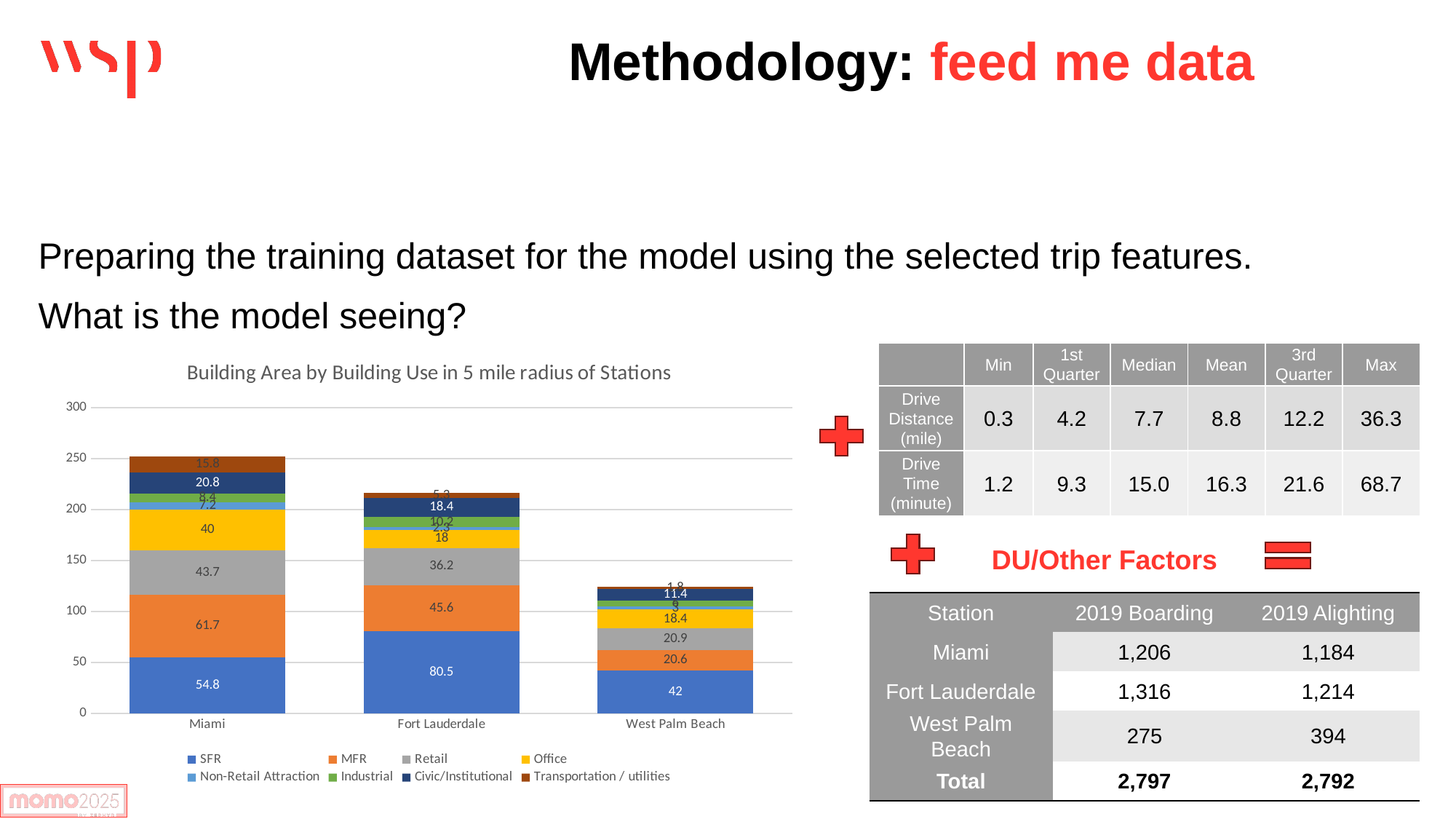
How many stations (categories) are shown on the x axis of the chart? 3 What is the title of the chart? Building Area by Building Use in 5 mile radius of Stations How many series does the chart's legend list? 8 What kind of chart is shown on the slide? Stacked bar chart Which station has the lowest total building area (shortest stacked bar)? West Palm Beach What is the difference between the SFR value for Fort Lauderdale and the SFR value for Miami? 25.7 What is the Retail value for West Palm Beach? 20.9 What is the MFR value for Miami? 61.7 What is the SFR value for Fort Lauderdale? 80.5 Which station has the highest SFR value? Fort Lauderdale Is the total stacked bar for West Palm Beach greater or less than 150? less Which is larger, the MFR value for Miami or the MFR value for Fort Lauderdale? Miami